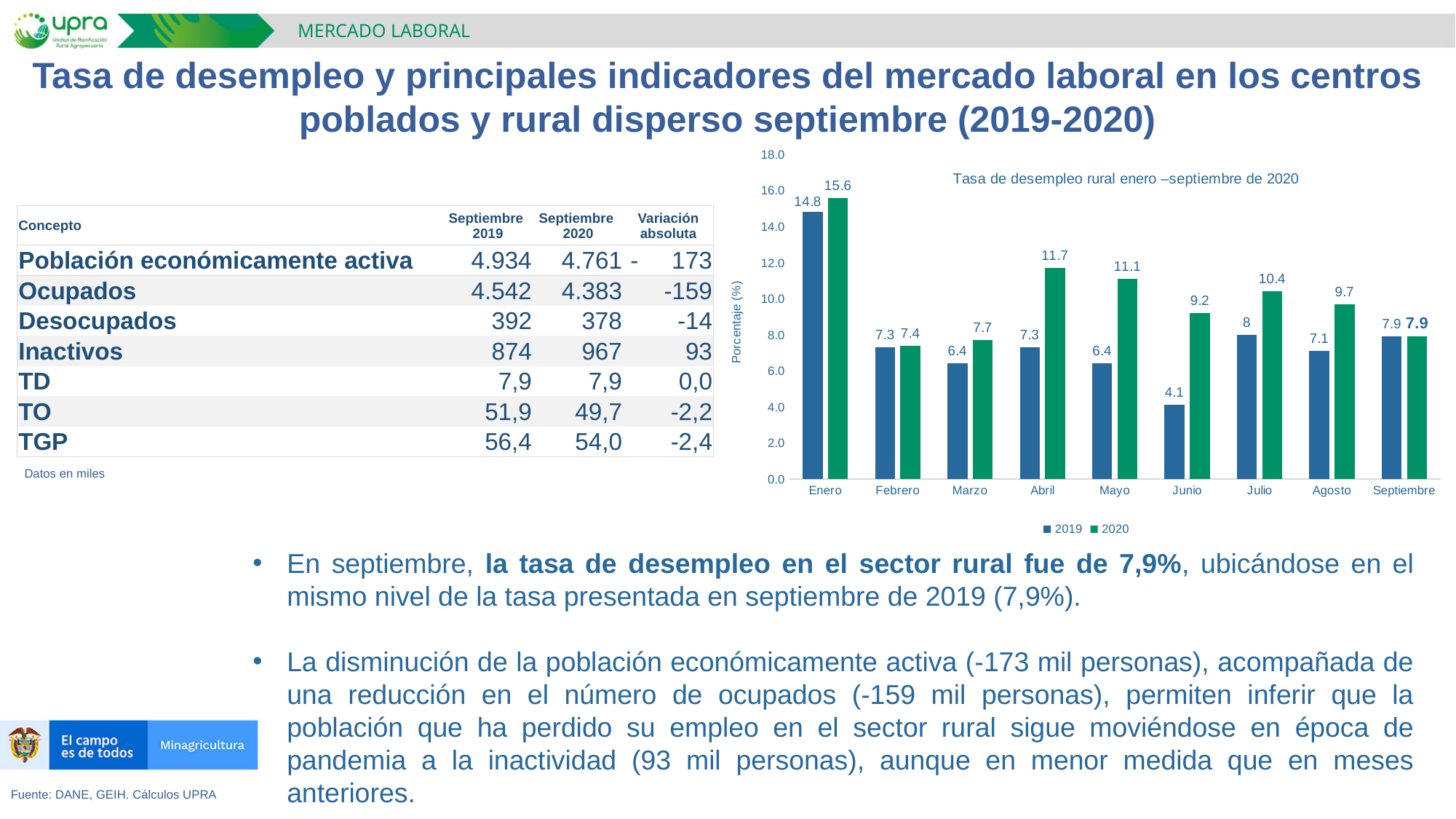
What kind of chart is shown on the slide? bar chart Which month has the highest 2020 value in the chart? Enero How many series does the chart legend list? 2 How many months are shown on the x axis of the chart? 9 Which is larger for Julio: the 2019 value or the 2020 value? 2020 Is the 2020 value for Junio greater or less than 8.0? greater What is the difference between the 2020 and 2019 values for Mayo? 4.7 What is the 2020 value for Enero in the chart? 15.6 What is the title of the chart on the slide? Tasa de desempleo rural enero –septiembre de 2020 What is the 2019 value for Junio in the chart? 4.1 What is the 2020 value for Abril in the chart? 11.7 Which month has the lowest 2019 value in the chart? Junio